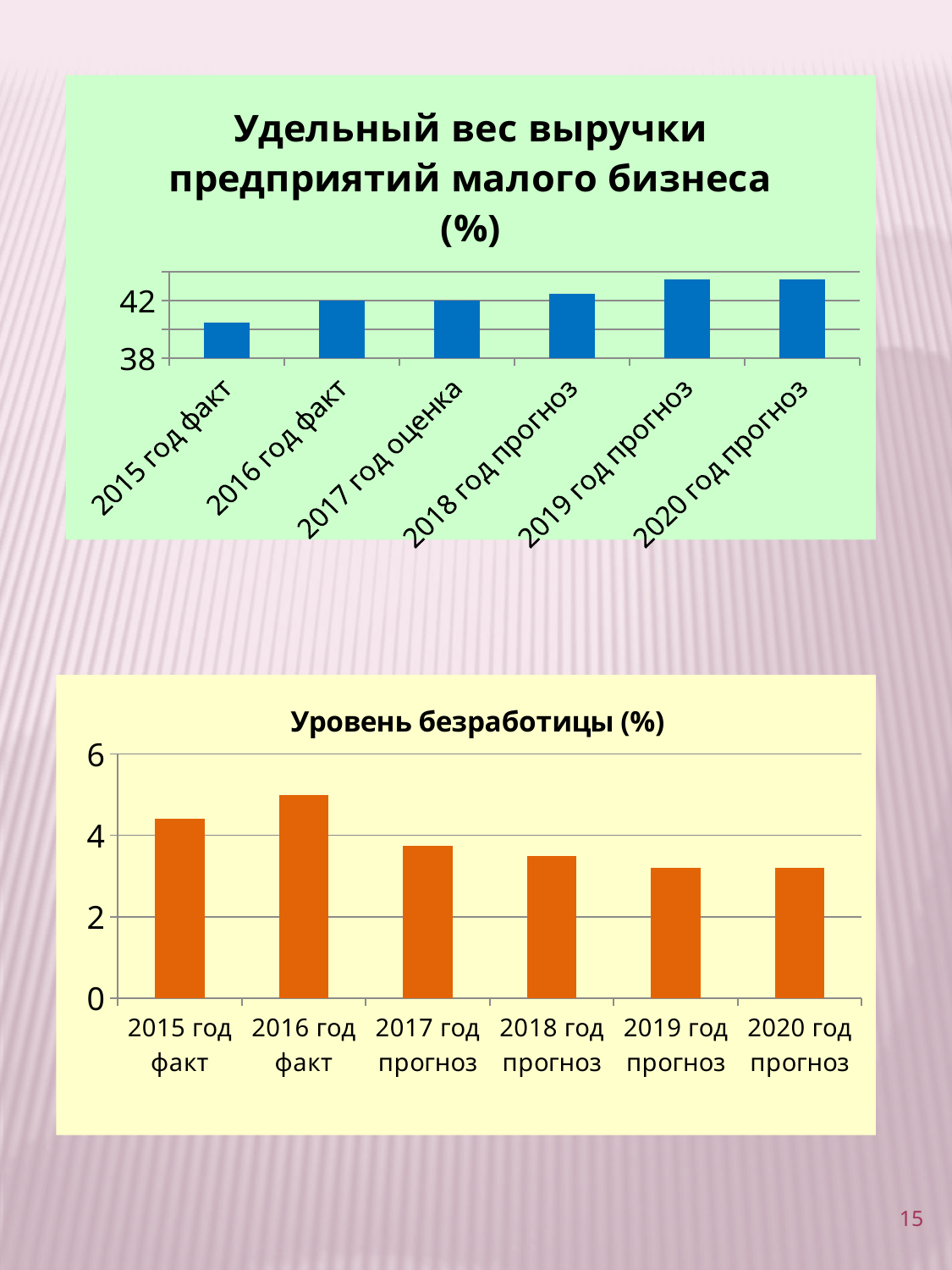
In the top chart 'Удельный вес выручки предприятий малого бизнеса (%)', do the values generally rise or fall from 2015 to 2020? rise In the top chart 'Удельный вес выручки предприятий малого бизнеса (%)', which is larger: the value for '2015 год факт' or '2018 год прогноз'? 2018 год прогноз In the bottom chart 'Уровень безработицы (%)', is the value for '2015 год факт' greater or less than 4? greater In the top chart 'Удельный вес выручки предприятий малого бизнеса (%)', which category has the lowest value? 2015 год факт In the bottom chart 'Уровень безработицы (%)', which category has the highest value? 2016 год факт What kind of chart is the bottom chart, 'Уровень безработицы (%)'? bar chart In the top chart 'Удельный вес выручки предприятий малого бизнеса (%)', how many categories are plotted? 6 In the bottom chart 'Уровень безработицы (%)', is the value for '2017 год прогноз' greater or less than 4? less What kind of chart is the top chart, 'Удельный вес выручки предприятий малого бизнеса (%)'? bar chart In the top chart 'Удельный вес выручки предприятий малого бизнеса (%)', is the value for '2019 год прогноз' greater or less than 42? greater In the bottom chart 'Уровень безработицы (%)', which is larger: the value for '2015 год факт' or '2018 год прогноз'? 2015 год факт